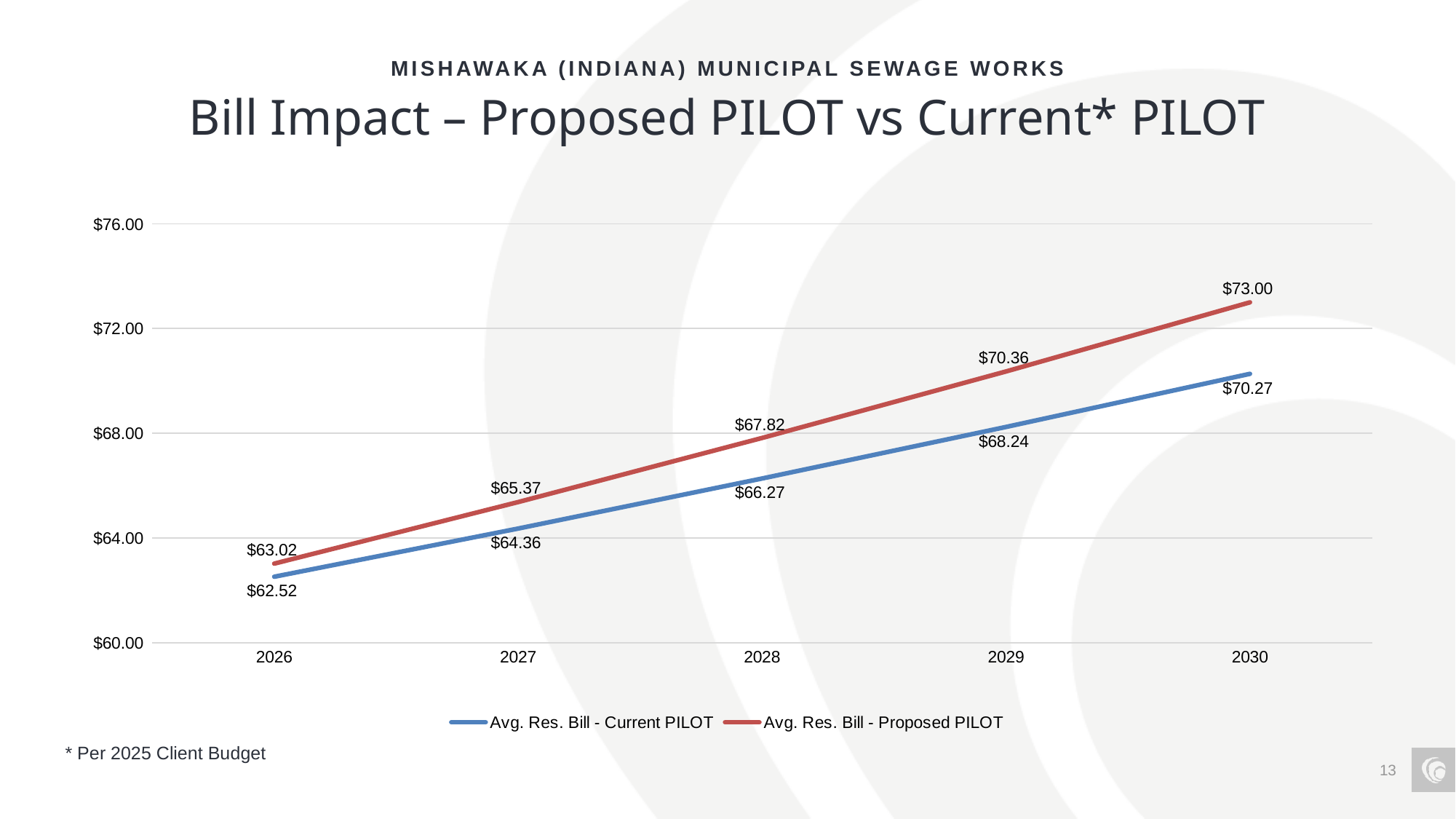
What is the Avg. Res. Bill - Proposed PILOT value for 2027? $65.37 In which year is the Avg. Res. Bill - Proposed PILOT highest? 2030 Do the Avg. Res. Bill - Current PILOT values rise or fall from 2026 to 2030? Rise How many series does the legend list? 2 What is the Avg. Res. Bill - Current PILOT value for 2028? $66.27 Which is larger in 2029: the Avg. Res. Bill - Proposed PILOT or the Avg. Res. Bill - Current PILOT? Avg. Res. Bill - Proposed PILOT What kind of chart is shown on the slide? Line chart In which year is the Avg. Res. Bill - Current PILOT lowest? 2026 What is the Avg. Res. Bill - Proposed PILOT value for 2030? $73.00 What is the Avg. Res. Bill - Current PILOT value for 2026? $62.52 What is the difference between the Proposed PILOT and Current PILOT bills in 2030? $2.73 How many years are plotted on the x axis? 5